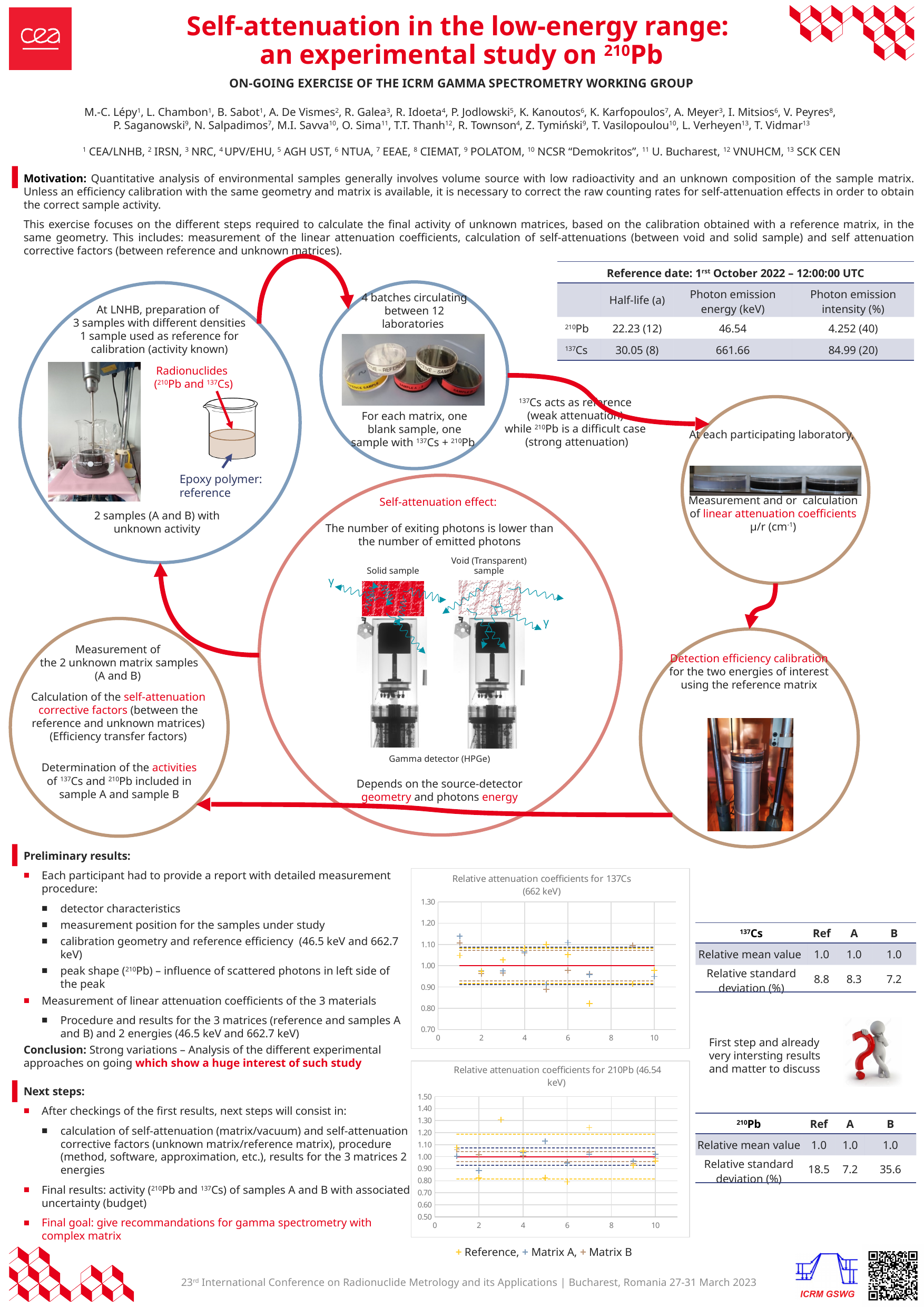
What is the title of the upper chart in the preliminary results section? Relative attenuation coefficients for 137Cs (662 keV) In the 210Pb (46.54 keV) chart, is the Reference value at x = 2 greater or less than 0.90? less In the 210Pb (46.54 keV) chart, is the Matrix A value at x = 5 greater or less than 1.10? greater In the 137Cs (662 keV) chart, is the Reference value at x = 7 greater or less than 0.90? less What kind of chart is the 'Relative attenuation coefficients for 210Pb (46.54 keV)' chart? scatter chart How many series does the legend below the two attenuation coefficient charts list? 3 What are the three series named in the legend below the attenuation coefficient charts? Reference, Matrix A, Matrix B What kind of chart is the 'Relative attenuation coefficients for 137Cs (662 keV)' chart? scatter chart